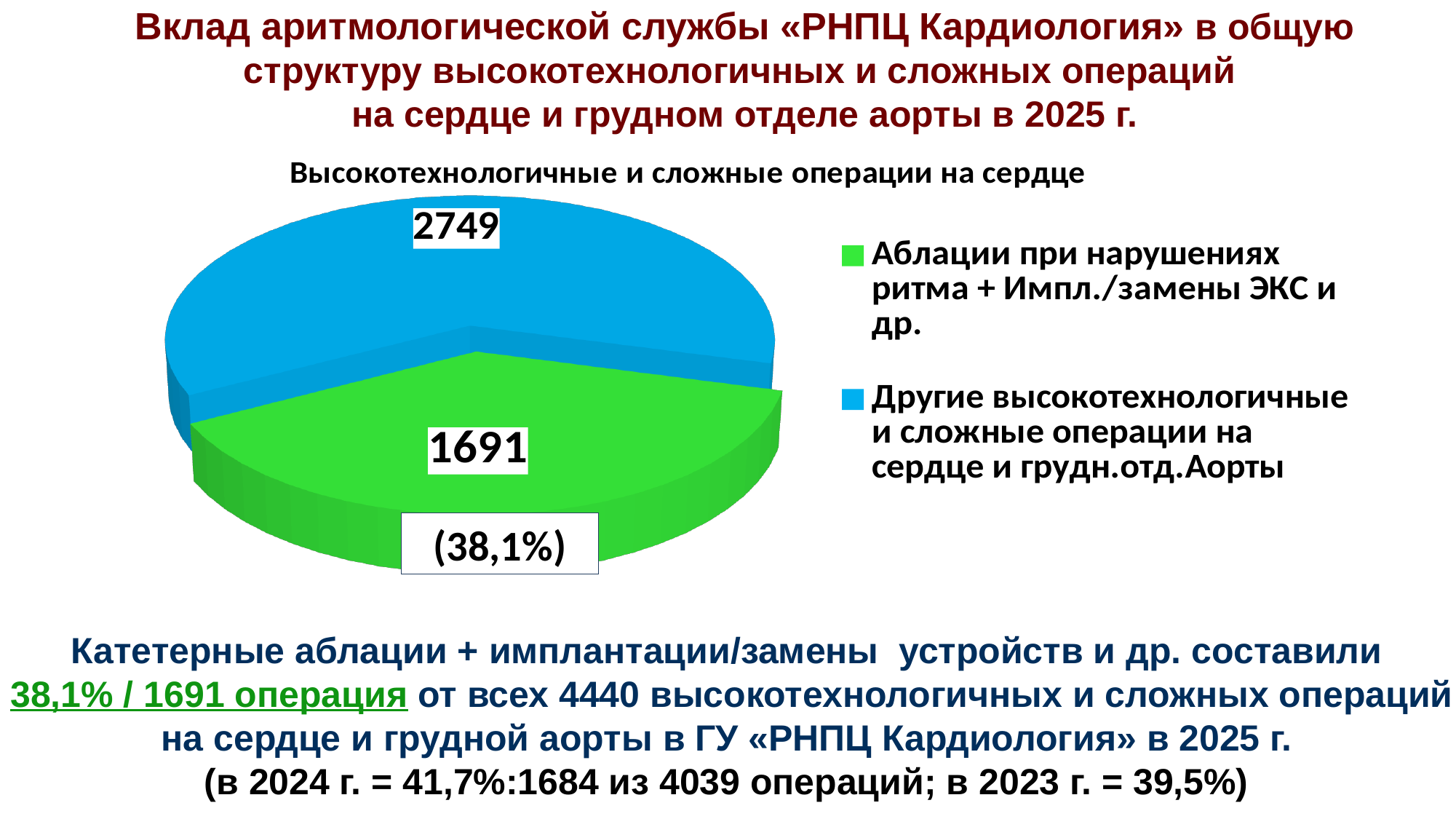
Which is larger: the slice for "Аблации при нарушениях ритма + Импл./замены ЭКС и др." or the slice for "Другие высокотехнологичные и сложные операции"? Другие высокотехнологичные и сложные операции What is the title of the chart? Высокотехнологичные и сложные операции на сердце What value is shown for the slice "Аблации при нарушениях ритма + Импл./замены ЭКС и др."? 1691 How many slices does the pie chart have? 2 What colour is the slice for "Другие высокотехнологичные и сложные операции на сердце и грудн.отд.Аорты"? Blue What percentage share is printed for the green slice (Аблации при нарушениях ритма + Импл./замены ЭКС и др.)? 38,1% Which slice of the pie chart is the largest? Другие высокотехнологичные и сложные операции на сердце и грудн.отд.Аорты What value is shown for the slice "Другие высокотехнологичные и сложные операции на сердце и грудн.отд.Аорты"? 2749 How many entries does the chart legend list? 2 What is the difference between the values of the two slices (2749 and 1691)? 1058 Which slice of the pie chart is the smallest? Аблации при нарушениях ритма + Импл./замены ЭКС и др. What type of chart is shown on the slide? Pie chart